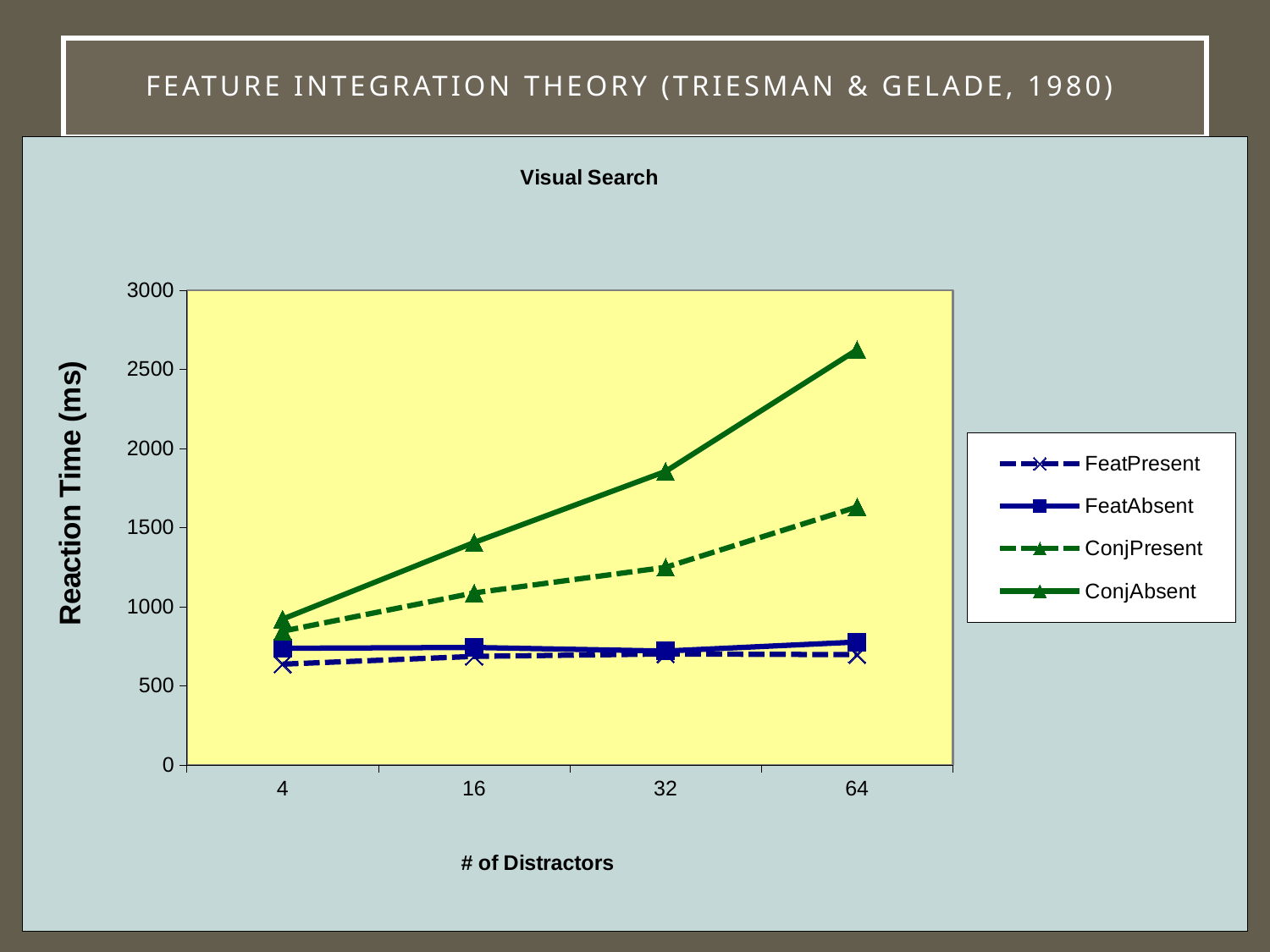
Which series has the lowest reaction time at 4 distractors? FeatPresent How many values of # of Distractors are plotted on the x axis? 4 Which series has the highest reaction time at 64 distractors? ConjAbsent What kind of chart is shown on the slide? Line chart Does the ConjAbsent series rise or fall as the number of distractors increases? rises Is the value for ConjPresent at 64 distractors greater or less than 1500? greater Is the value for ConjAbsent at 32 distractors greater or less than 2000? less How many series does the legend list? 4 Is the value for ConjAbsent at 64 distractors greater or less than 2500? greater At 32 distractors, which is larger: ConjAbsent or ConjPresent? ConjAbsent What is the label of the y axis? Reaction Time (ms)